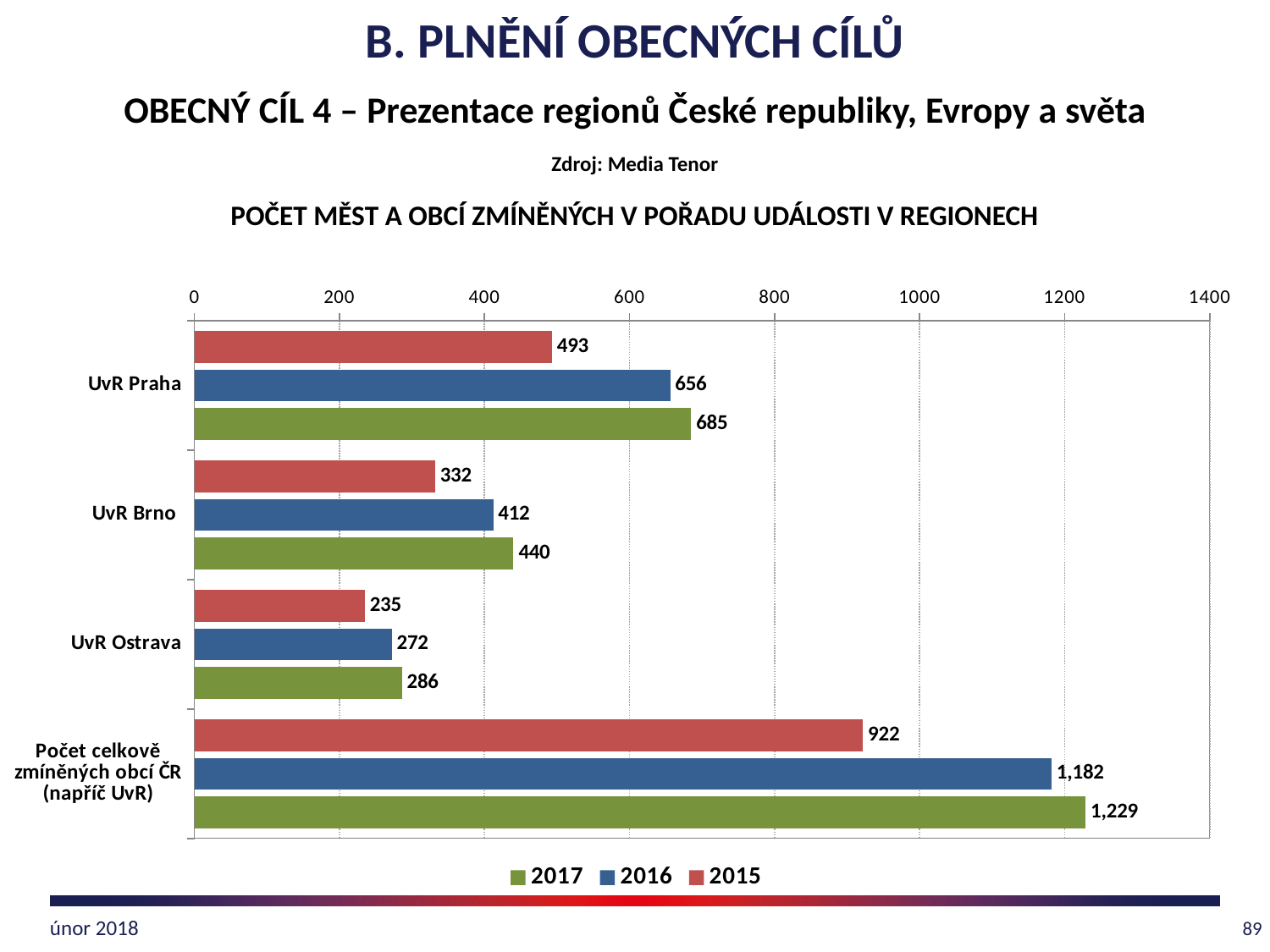
Which category has the lowest 2015 value? UvR Ostrava Which category has the highest 2017 value? Počet celkově zmíněných obcí ČR (napříč UvR) How many categories are shown on the y axis? 4 What is the title of the chart? POČET MĚST A OBCÍ ZMÍNĚNÝCH V POŘADU UDÁLOSTI V REGIONECH What is the value for UvR Brno in 2015? 332 How many series does the legend list? 3 What kind of chart is shown? bar chart What is the difference between the 2017 and 2015 values for UvR Praha? 192 What is the 2016 value for Počet celkově zmíněných obcí ČR (napříč UvR)? 1,182 What is the value for UvR Praha in 2017? 685 Is the 2015 value for Počet celkově zmíněných obcí ČR (napříč UvR) greater or less than 1000? less Which is larger: the 2016 value for UvR Brno or the 2017 value for UvR Ostrava? 2016 value for UvR Brno